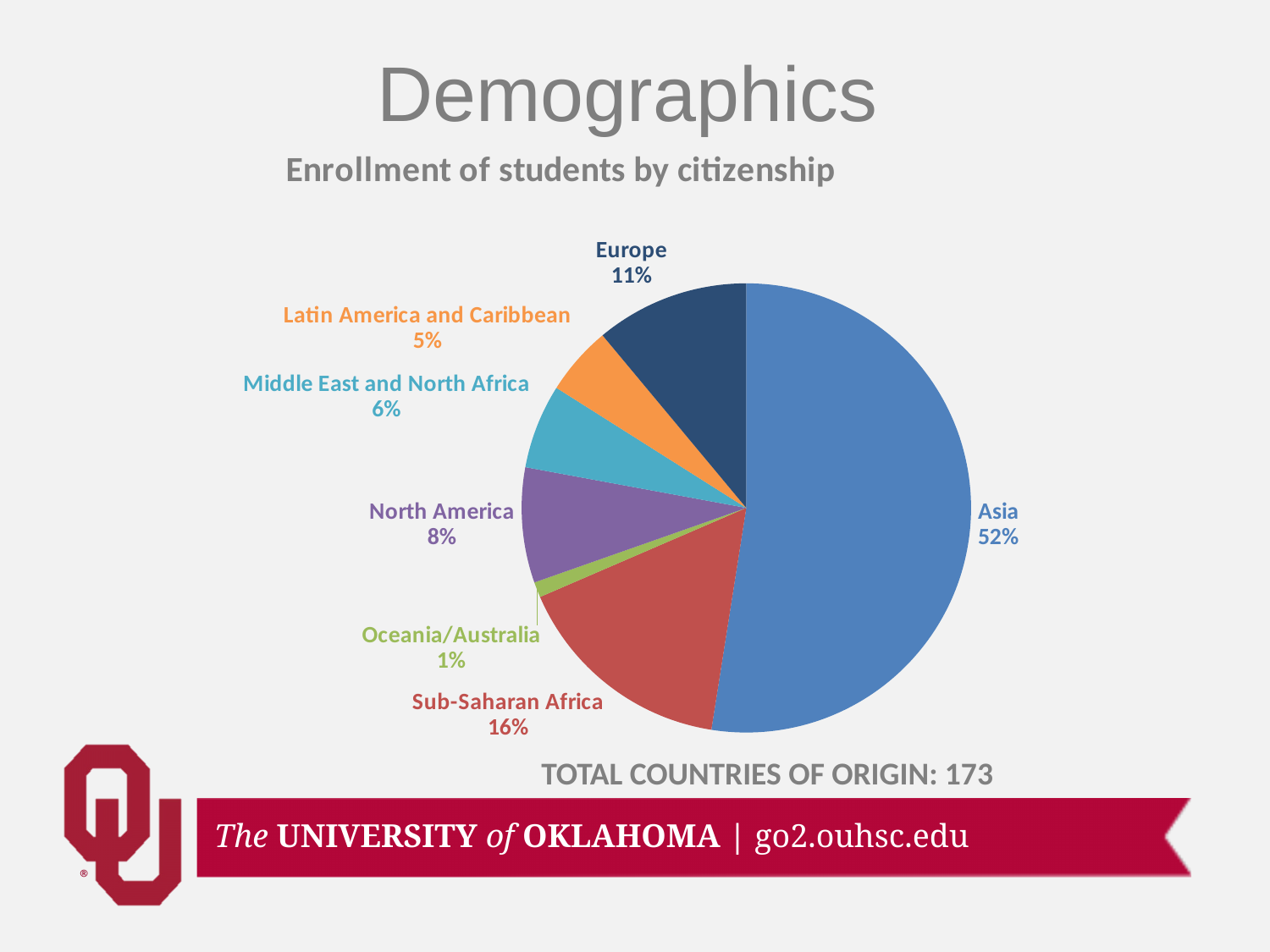
What percentage is shown for Middle East and North Africa? 6% What is the difference in percentage points between Asia and Sub-Saharan Africa? 36 How many regions are shown in the pie chart? 7 What is the subtitle of the chart? Enrollment of students by citizenship Which region has the smallest share of the pie? Oceania/Australia What percentage of students are from Sub-Saharan Africa? 16% What type of chart is shown on the slide? Pie chart Which region has the largest share of the pie? Asia What is the total number of countries of origin stated on the slide? 173 What is the value shown for Europe? 11% Which has a larger share, North America or Europe? Europe What share of enrollment is from Asia? 52%